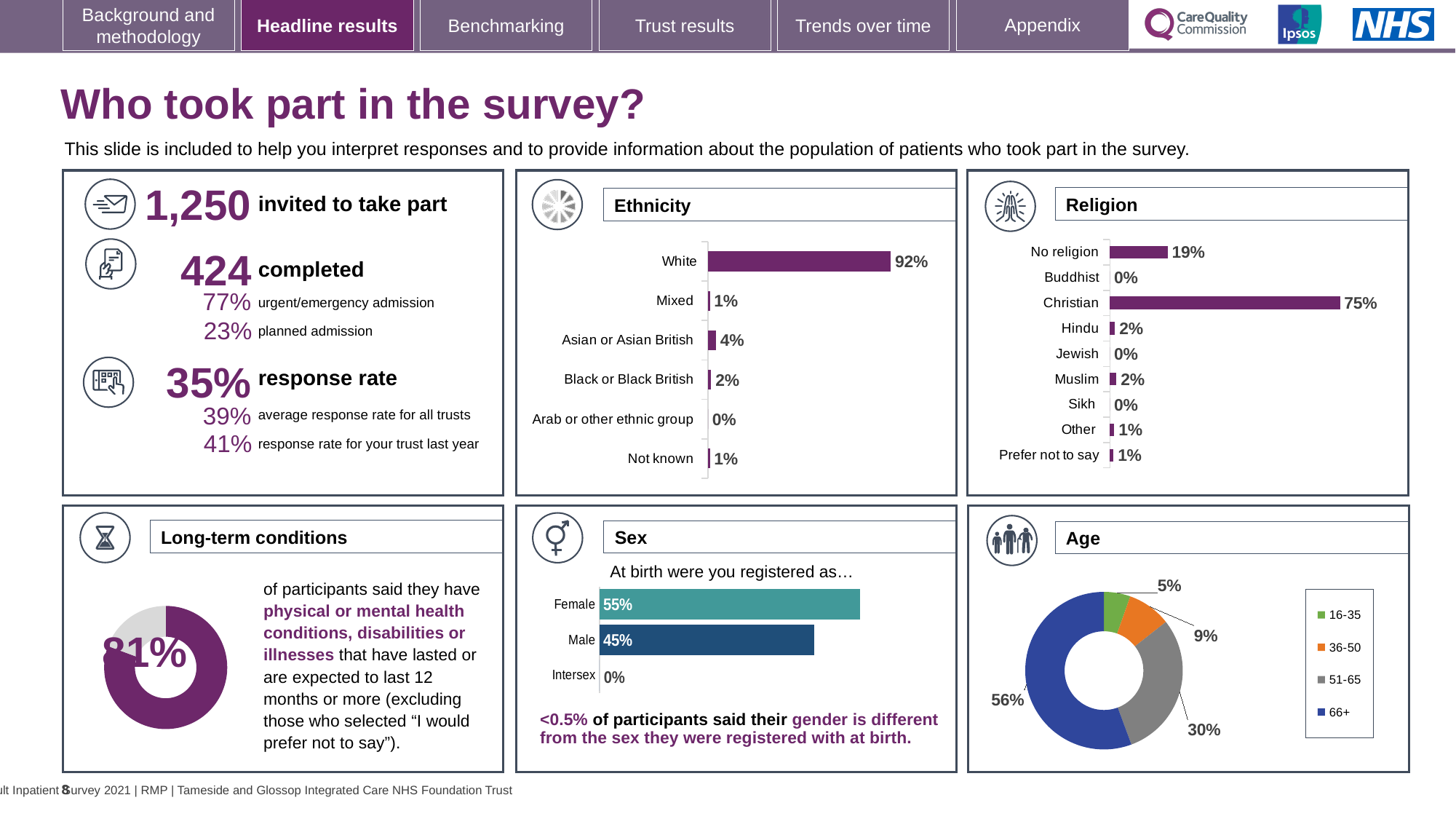
In the Age chart, which age group has the smallest share? 16-35 In the Religion chart, what is the difference between the Christian and No religion percentages? 56% How many age groups does the legend of the Age chart list? 4 How many religion categories are listed in the Religion chart? 9 In the Religion chart, what percentage of participants were Christian? 75% In the Age chart, what share of participants were aged 66+? 56% What kind of chart is used to show the Age breakdown? Donut (pie) chart In the Sex chart, what percentage of participants were registered as Female at birth? 55% In the Ethnicity chart, what percentage of participants were White? 92% In the Ethnicity chart, which ethnic group has the highest percentage? White In the Sex chart, which is larger, the Female or the Male percentage? Female How many ethnic group categories are shown in the Ethnicity chart? 6